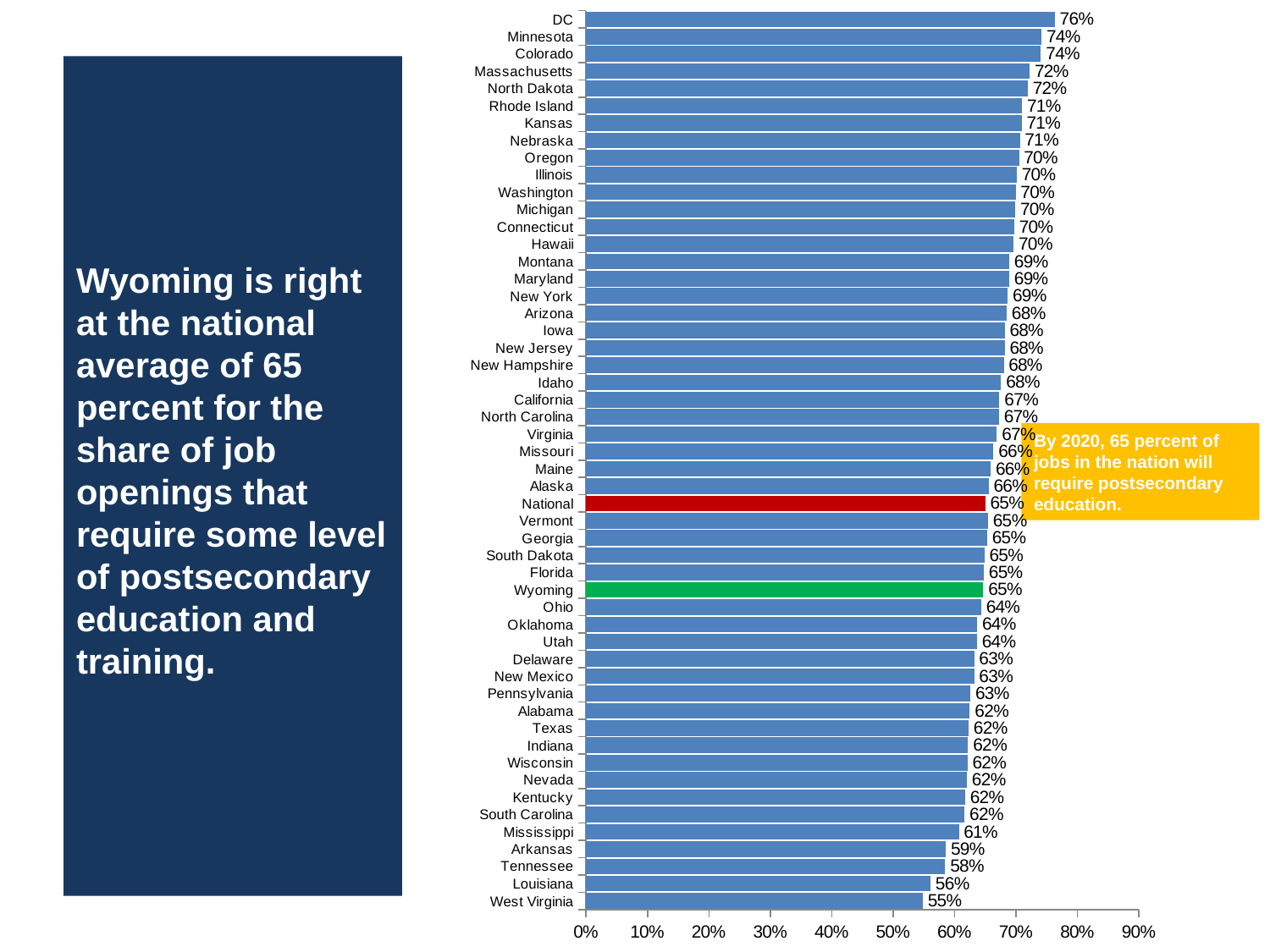
Which category has the lowest value? West Virginia What is the difference between the values for Massachusetts and Mississippi? 11% What is the value for the National bar? 65% Which is larger, the value for Minnesota or the value for Louisiana? Minnesota What is the value for Wyoming? 65% What colour is the Wyoming bar? Green What colour is the National bar? Red What is the value for West Virginia? 55% What kind of chart is shown on the slide? Bar chart Which category has the highest value? DC What is the value for Tennessee? 58% What is the difference between the values for DC and West Virginia? 21%